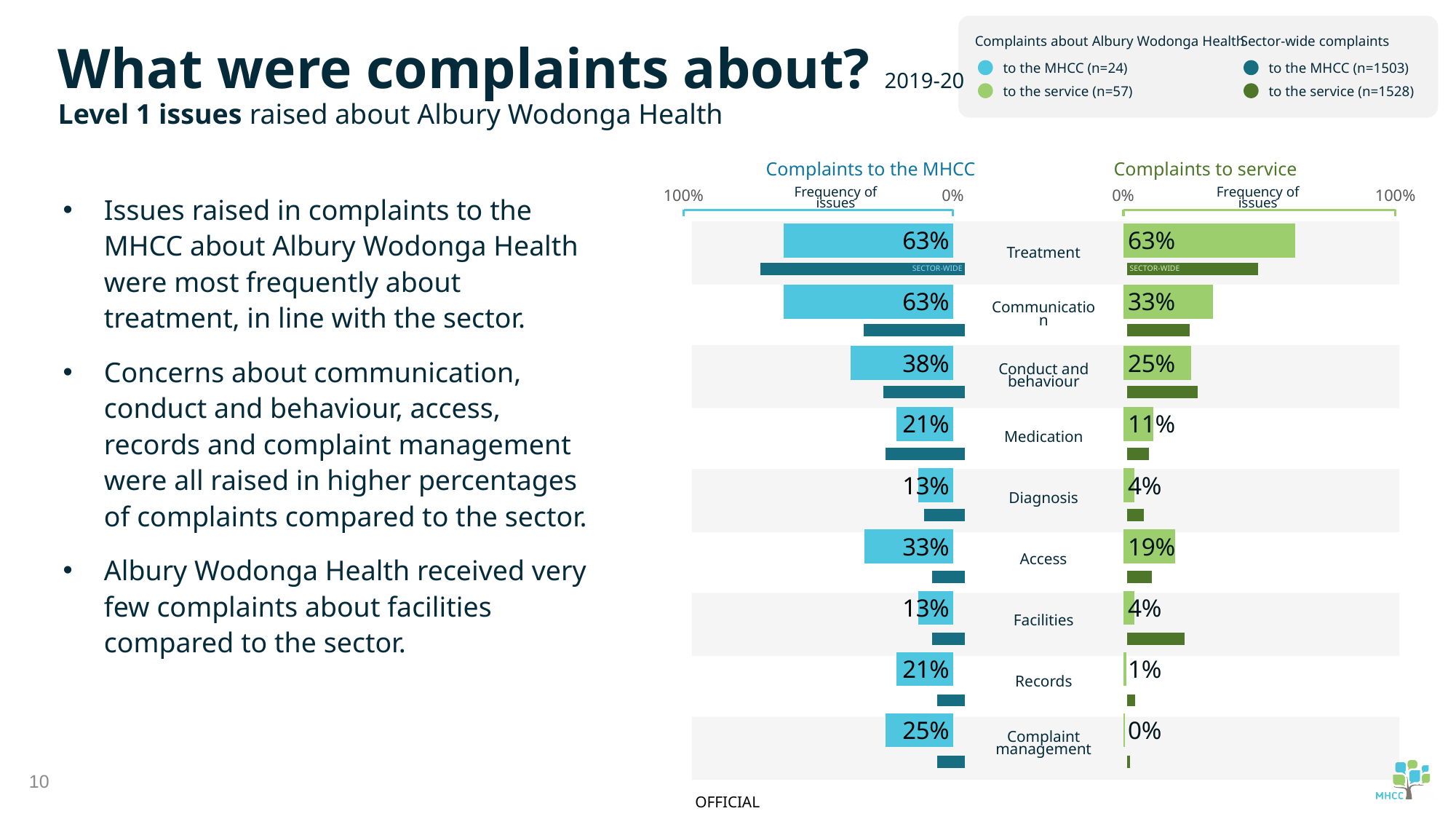
How many issue categories are listed in the 'Complaints to the MHCC' chart? 9 In the 'Complaints to the MHCC' chart, which is larger: the value for Records or the value for Complaint management? Complaint management In the 'Complaints to service' chart, what percentage of complaints were about Communication? 33% In the 'Complaints to the MHCC' chart, what is the difference between the values for Access and Medication? 12% In the 'Complaints to service' chart, what is the difference between the values for Treatment and Communication? 30% In the 'Complaints to service' chart, which category has the highest value? Treatment In the 'Complaints to service' chart, which category has the lowest value? Complaint management What type of chart is the 'Complaints to service' chart? Bar chart In the 'Complaints to the MHCC' chart, what percentage of complaints were about Treatment? 63% According to the legend, how many complaints to the MHCC about Albury Wodonga Health were there (n)? 24 In the 'Complaints to the MHCC' chart, what is the value for Conduct and behaviour? 38% In the 'Complaints to service' chart, what is the value for Complaint management? 0%